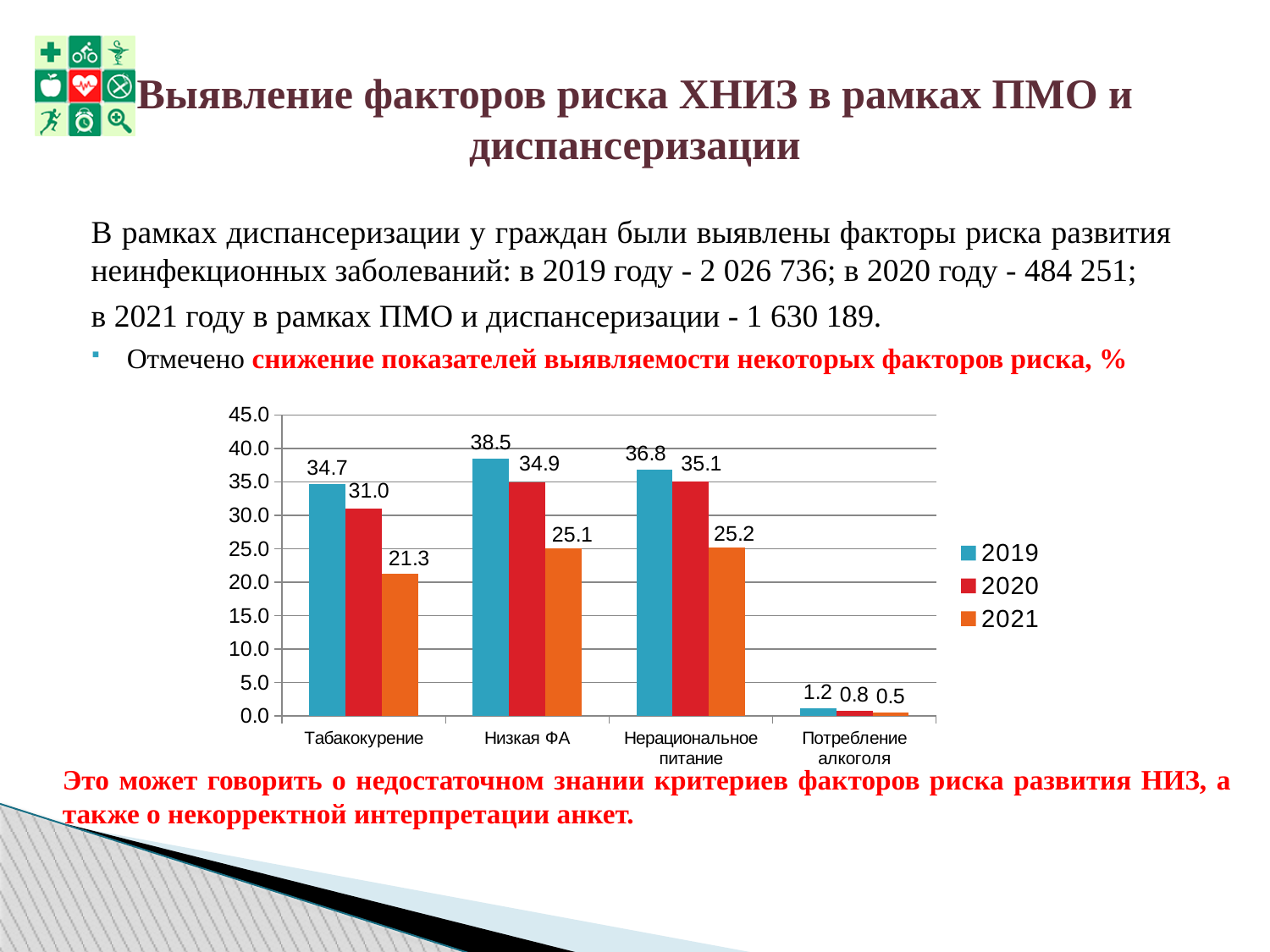
How many series does the chart legend list? 3 Which category has the highest value in 2019? Низкая ФА Which series is shown in orange in the chart legend? 2021 Do the values for Нерациональное питание rise or fall from 2019 to 2021? fall How many categories are shown on the x axis of the chart? 4 What is the difference between the 2019 and 2021 values for Табакокурение? 13.4 What type of chart is shown on the slide? bar chart What is the value for Низкая ФА in 2021? 25.1 What is the value for Потребление алкоголя in 2020? 0.8 Which category has the lowest value in 2021? Потребление алкоголя What is the value for Табакокурение in 2019? 34.7 Which is larger: the 2020 value for Низкая ФА or the 2020 value for Нерациональное питание? Нерациональное питание